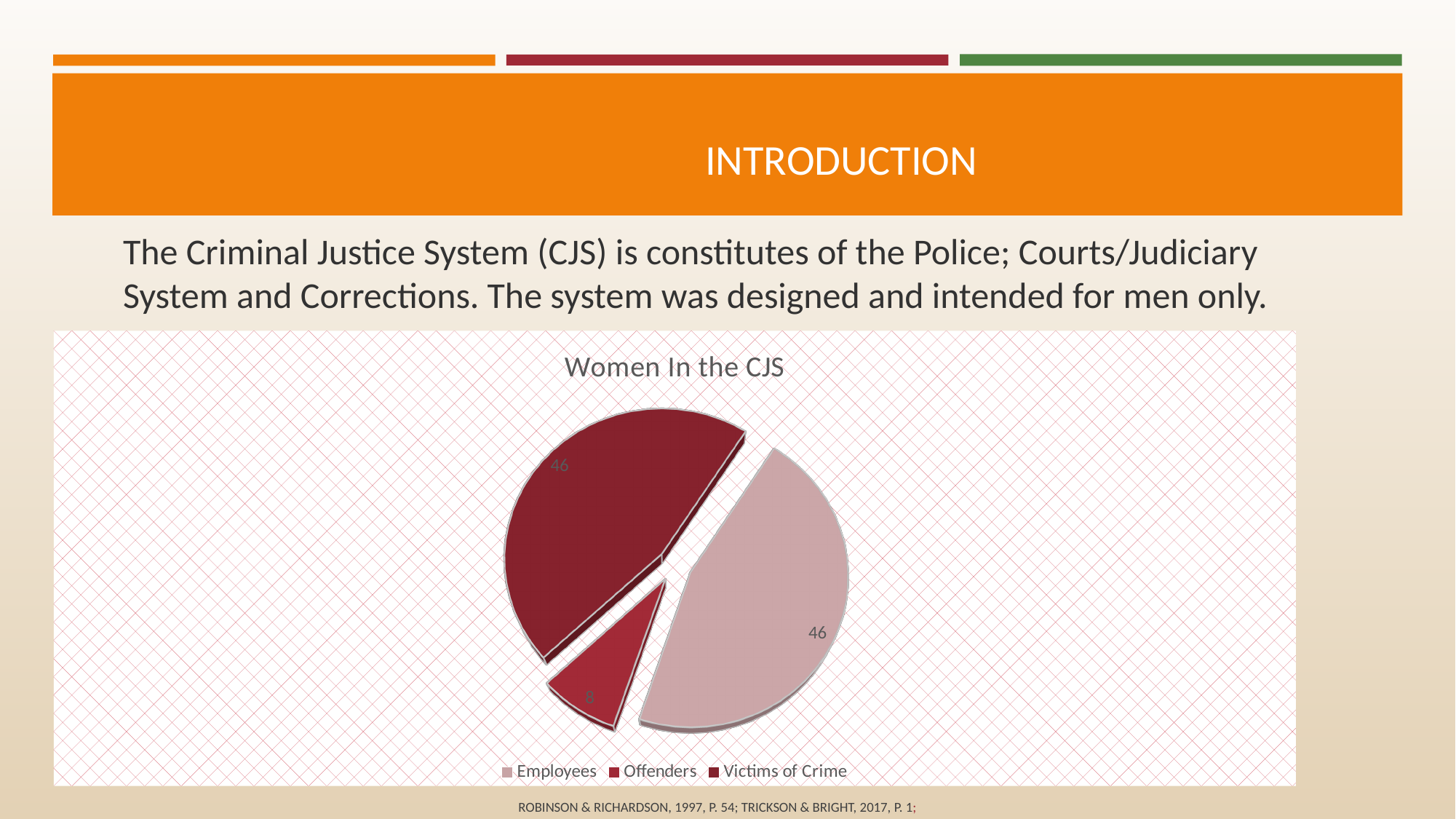
Which category has the smallest slice in the Women In the CJS pie chart? Offenders What are the three legend entries of the chart on the slide? Employees, Offenders, Victims of Crime How many slices does the Women In the CJS pie chart have? 3 What is the total of all slices in the Women In the CJS pie chart? 100 What is the value for Offenders in the Women In the CJS pie chart? 8 What is the title of the chart on the slide? Women In the CJS What is the difference between the values for Employees and Offenders in the Women In the CJS chart? 38 What share of the Women In the CJS pie does the Offenders slice represent? 8% Which is larger in the Women In the CJS chart, Victims of Crime or Offenders? Victims of Crime What kind of chart is shown on the slide? Pie chart What is the value for Employees in the Women In the CJS pie chart? 46 What is the value for Victims of Crime in the Women In the CJS pie chart? 46